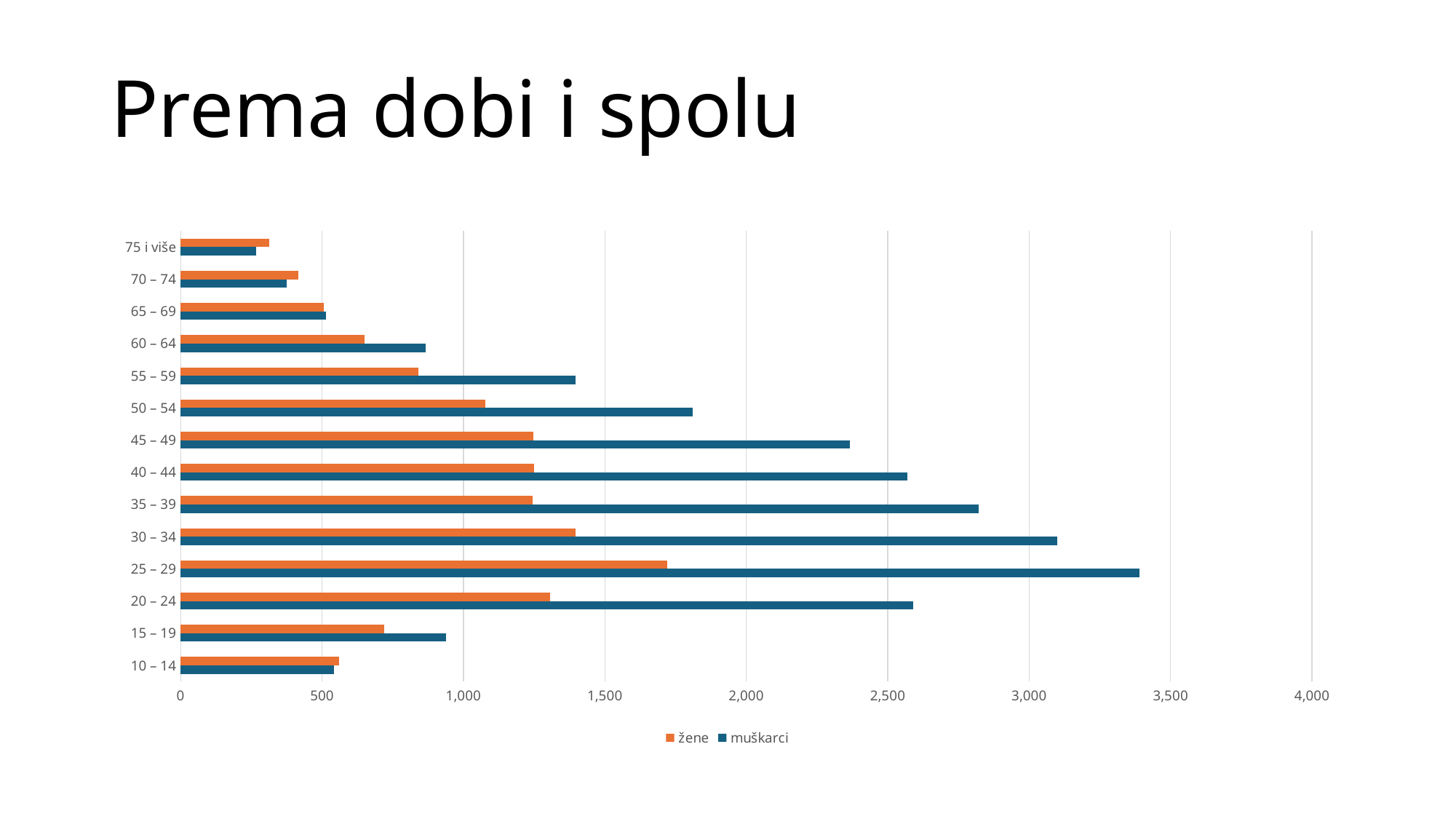
Which age category has the lowest value for muškarci? 75 i više Which age category has the highest value for muškarci? 25 – 29 How many age categories are plotted on the chart? 14 Is the value for muškarci in the 25 – 29 category greater or less than 3,000? greater How many series does the legend list? 2 In the 40 – 44 category, which series has the larger value, žene or muškarci? muškarci Is the value for žene in the 25 – 29 category greater or less than 1,500? greater Is the value for muškarci in the 45 – 49 category greater or less than 2,000? greater Which age category has the highest value for žene? 25 – 29 What is the title of the slide? Prema dobi i spolu What kind of chart is shown on the slide? bar chart